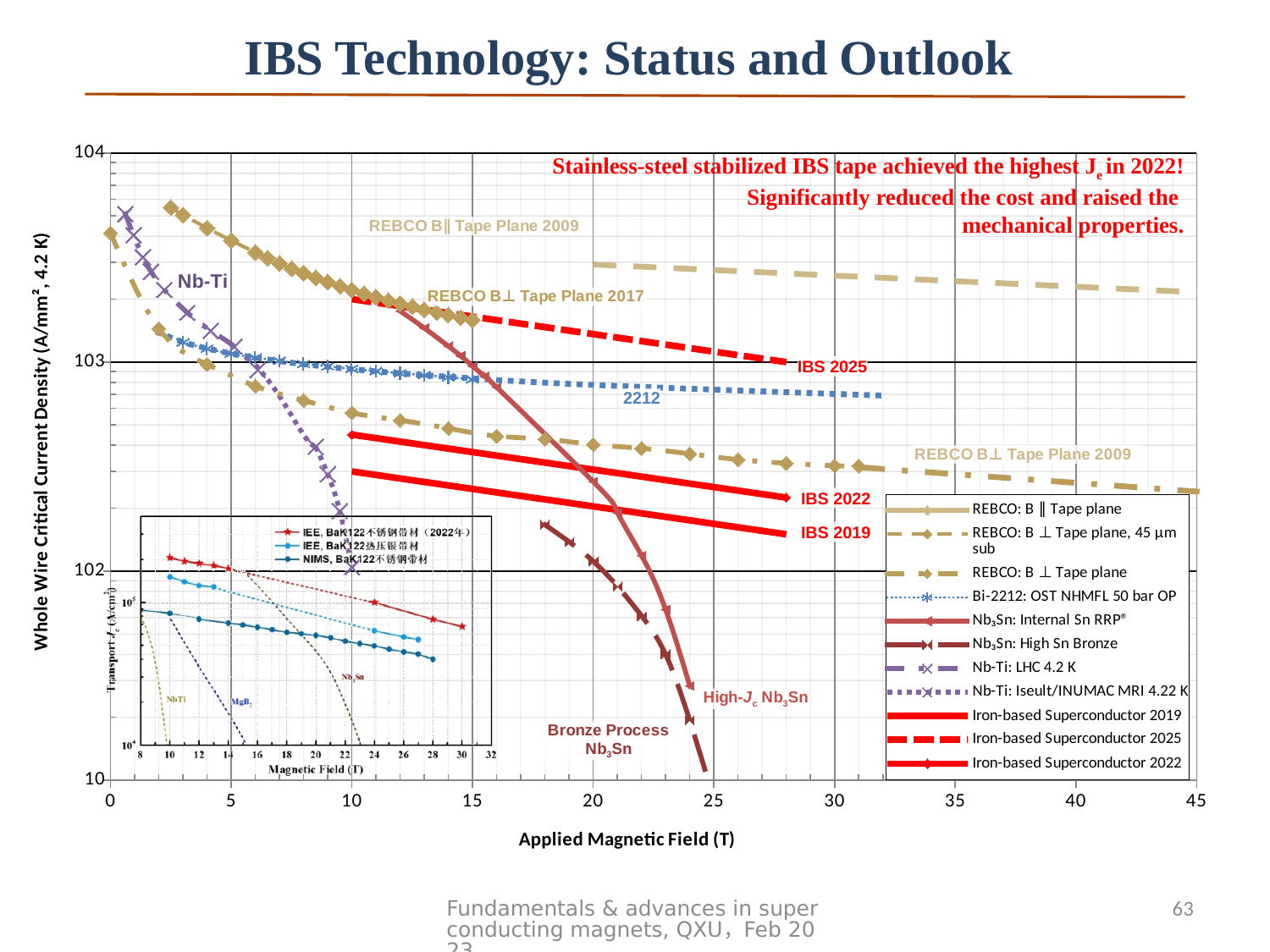
In the main chart, is the value of the Bi-2212 curve at 30 T greater or less than 10³? less In the main chart, is the value of the Nb-Ti: Iseult/INUMAC MRI 4.22 K curve at 10 T greater or less than 10³? less What is the largest value shown on the x axis of the main chart? 45 In the main chart, which is higher at 20 T: the Iron-based Superconductor 2022 curve or the Iron-based Superconductor 2019 curve? Iron-based Superconductor 2022 How many series does the legend of the main chart list? 11 What is the label of the x axis of the main chart? Applied Magnetic Field (T) In the main chart, is the value of the IBS 2025 curve at 20 T greater or less than 10³? greater In the main chart, do the critical current density values rise or fall as the applied magnetic field increases? fall What is the label of the y axis of the main chart? Whole Wire Critical Current Density (A/mm², 4.2 K) What kind of chart is the main chart on the slide? line chart In the main chart, which series has the highest value at 40 T? REBCO: B ⊥ Tape plane, 45 μm sub